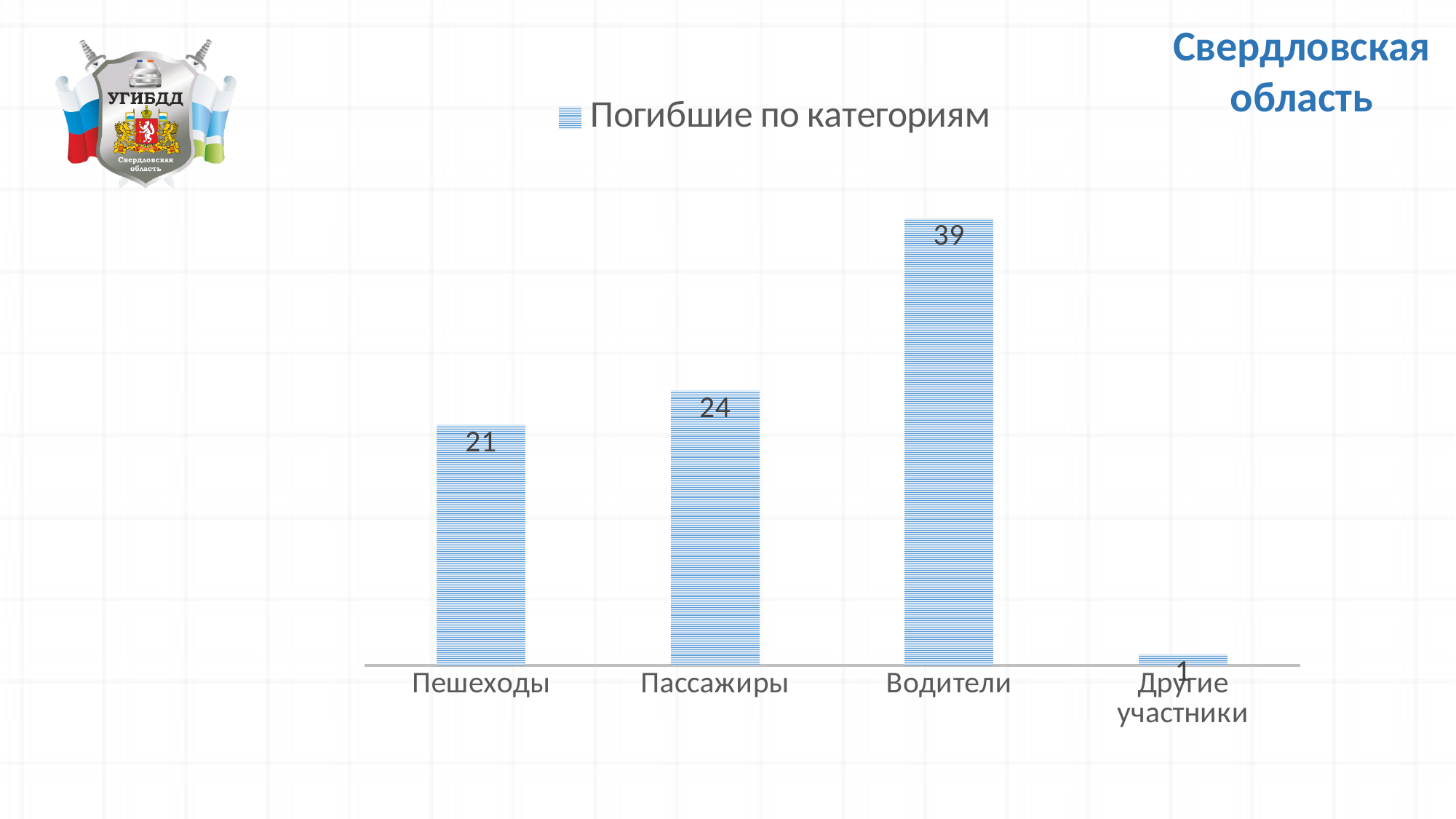
What is the value for Другие участники? 1 What is the value for Водители? 39 Which is larger, the value for Пассажиры or the value for Пешеходы? Пассажиры What series name does the legend show? Погибшие по категориям What is the difference between the values for Водители and Пешеходы? 18 Which category has the lowest value? Другие участники What is the value for Пассажиры? 24 What is the difference between the values for Пассажиры and Пешеходы? 3 How many categories are shown on the x axis? 4 Which category has the highest value? Водители What kind of chart is shown on the slide? bar chart What is the value for Пешеходы? 21